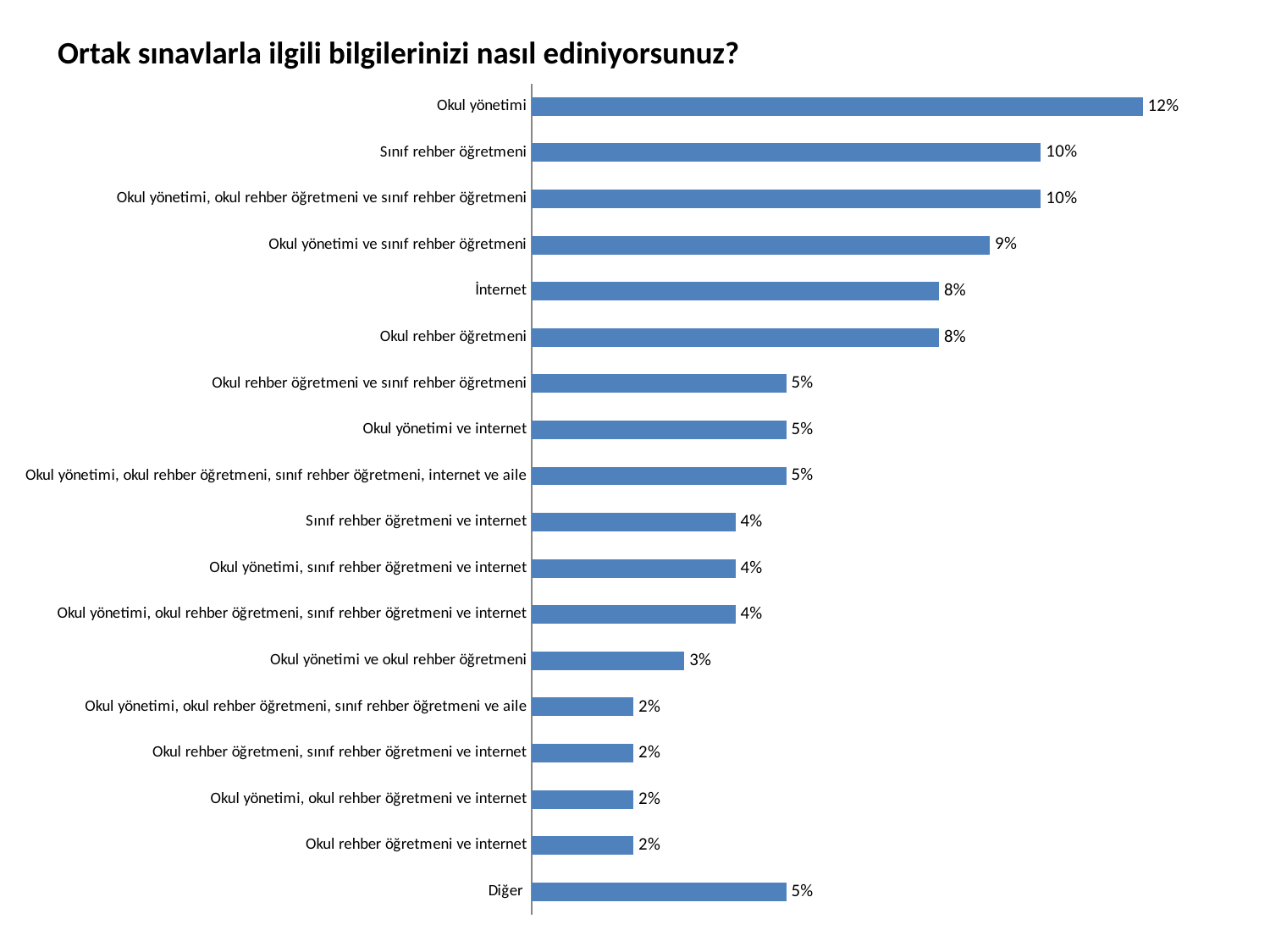
Which category has the highest value? Okul yönetimi What type of chart is shown on the slide? bar chart How many categories are shown in the chart? 18 Which is larger, the value for İnternet or the value for Okul yönetimi ve internet? İnternet What is the lowest value shown in the chart? 2% What is the value for Diğer? 5% What is the difference between the values for Okul yönetimi and Sınıf rehber öğretmeni? 2% What is the value for Okul yönetimi? 12% What is the title of the chart? Ortak sınavlarla ilgili bilgilerinizi nasıl ediniyorsunuz? What is the value for Okul yönetimi ve sınıf rehber öğretmeni? 9% What is the value for Okul yönetimi ve okul rehber öğretmeni? 3% What is the value for İnternet? 8%